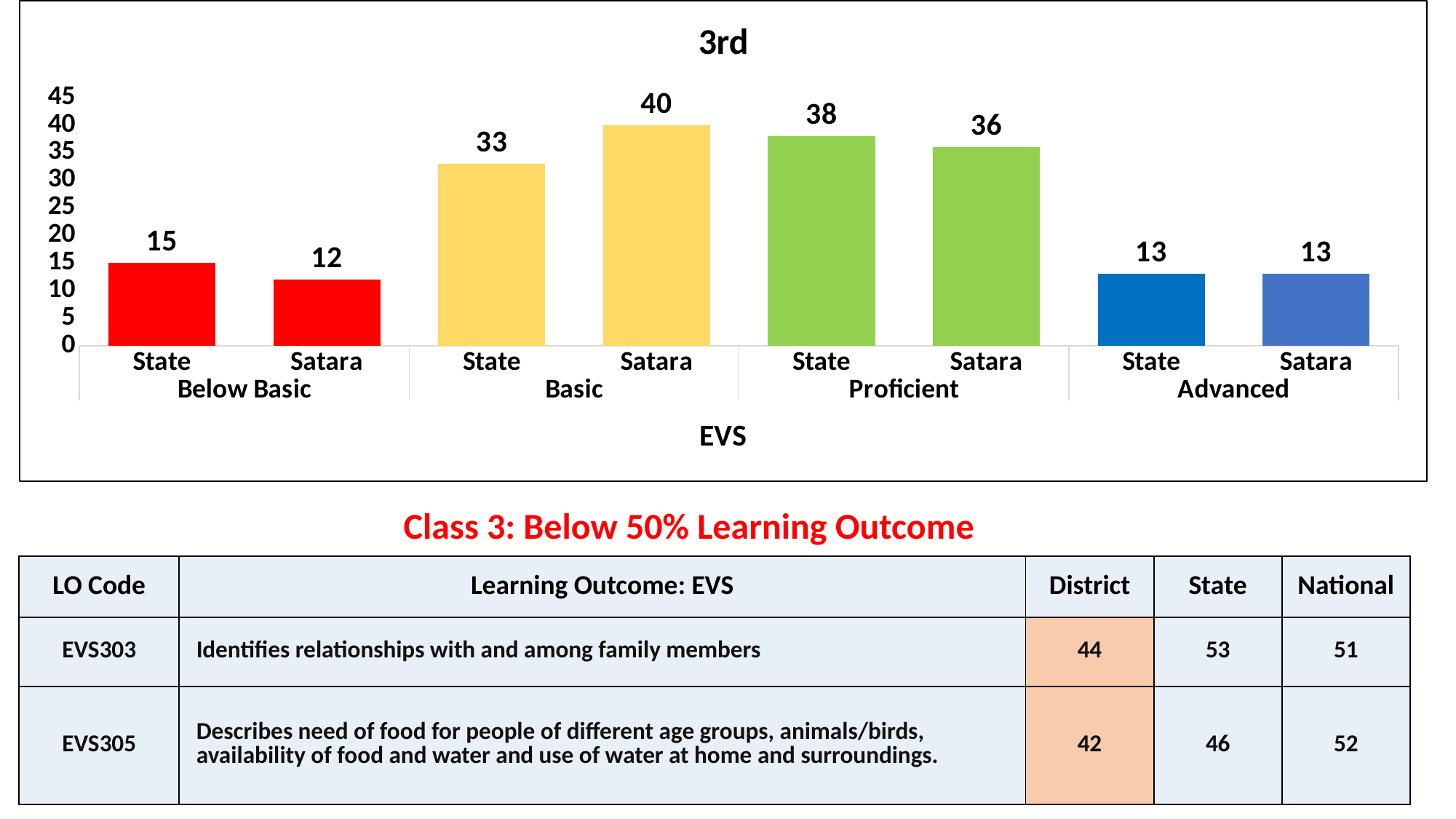
What kind of chart is shown on the slide? Bar chart What is the title of the chart? 3rd What is the value for Satara in the Basic category? 40 How many bars are plotted in the chart? 8 What is the difference between the State and Satara values in the Proficient category? 2 What is the value for State in the Below Basic category? 15 What is the difference between the State and Satara values in the Basic category? 7 What is the value for Satara in the Proficient category? 36 What is the x-axis label of the chart? EVS Which bar has the lowest value in the chart? Satara, Below Basic Which bar has the highest value in the chart? Satara, Basic Which is larger in the Below Basic category, State or Satara? State